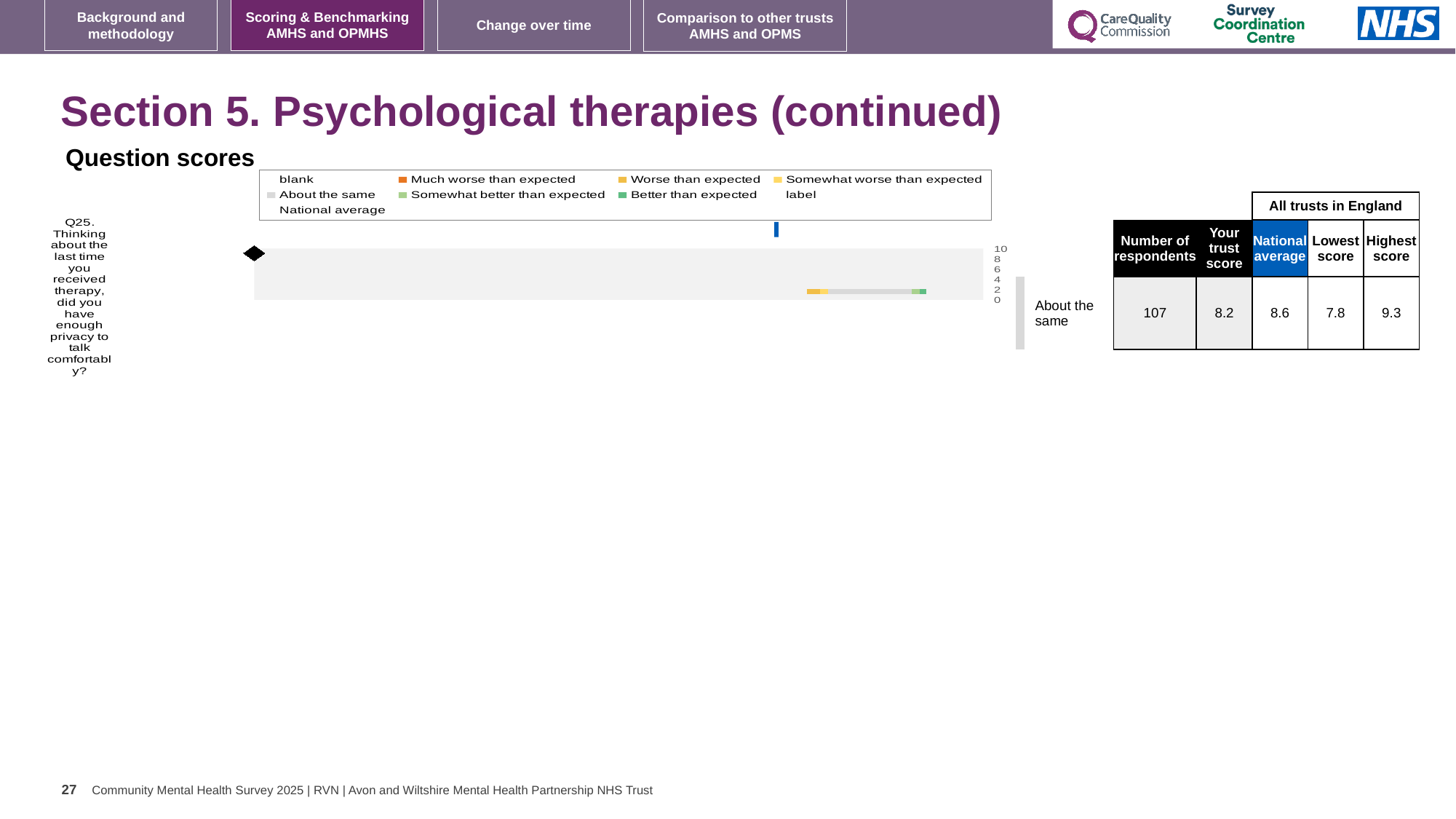
What is the highest value shown on the score axis of the Question scores chart? 10 In the table beside the Question scores chart, what is the highest score among all trusts in England for Q25? 9.3 In the table beside the Question scores chart, what is the lowest score among all trusts in England for Q25? 7.8 In the table beside the Question scores chart, what is the number of respondents for Q25? 107 In the table beside the Question scores chart, what is 'Your trust score' for Q25? 8.2 Which question is plotted in the Question scores chart? Q25. Thinking about the last time you received therapy, did you have enough privacy to talk comfortably? For Q25, what is the difference between the highest score and the lowest score among all trusts in England? 1.5 What benchmark category is shown next to Q25 in the Question scores chart? About the same For Q25, which is larger: the trust score or the national average? national average How many questions are plotted in the Question scores chart? 1 What kind of chart is shown under 'Question scores'? bar chart In the table beside the Question scores chart, what is the national average for Q25? 8.6